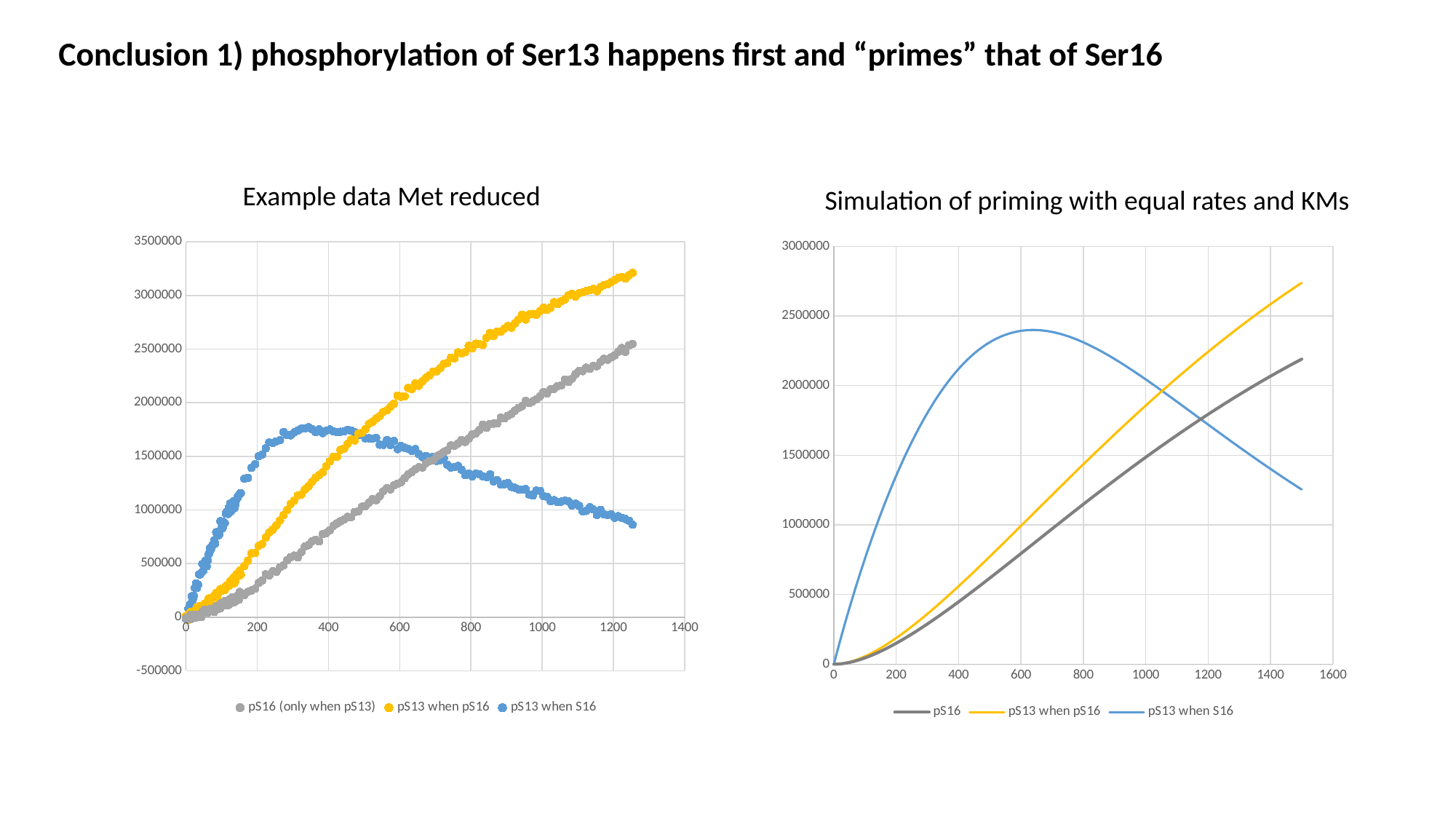
In the "Simulation of priming with equal rates and KMs" chart, is the peak value of the pS13 when S16 series greater or less than 2000000? greater What kind of chart is the right chart titled "Simulation of priming with equal rates and KMs"? line chart In the "Example data Met reduced" chart, is the final value of the pS13 when pS16 series greater or less than 3000000? greater In the "Simulation of priming with equal rates and KMs" chart, what is the largest tick label on the x axis? 1600 In the "Simulation of priming with equal rates and KMs" chart, how does the pS13 when S16 series change along the x axis? rises then falls What kind of chart is the left chart titled "Example data Met reduced"? scatter chart In the "Example data Met reduced" chart, how many series does the legend list? 3 In the "Simulation of priming with equal rates and KMs" chart, at x = 1400, which is larger: pS13 when pS16 or pS16? pS13 when pS16 In the "Example data Met reduced" chart, is the peak value of the pS13 when S16 series greater or less than 1500000? greater In the "Example data Met reduced" chart, what is the legend label of the gray series? pS16 (only when pS13) In the "Example data Met reduced" chart, which series reaches the highest value at the right end of the data? pS13 when pS16 In the "Simulation of priming with equal rates and KMs" chart, how many series does the legend list? 3